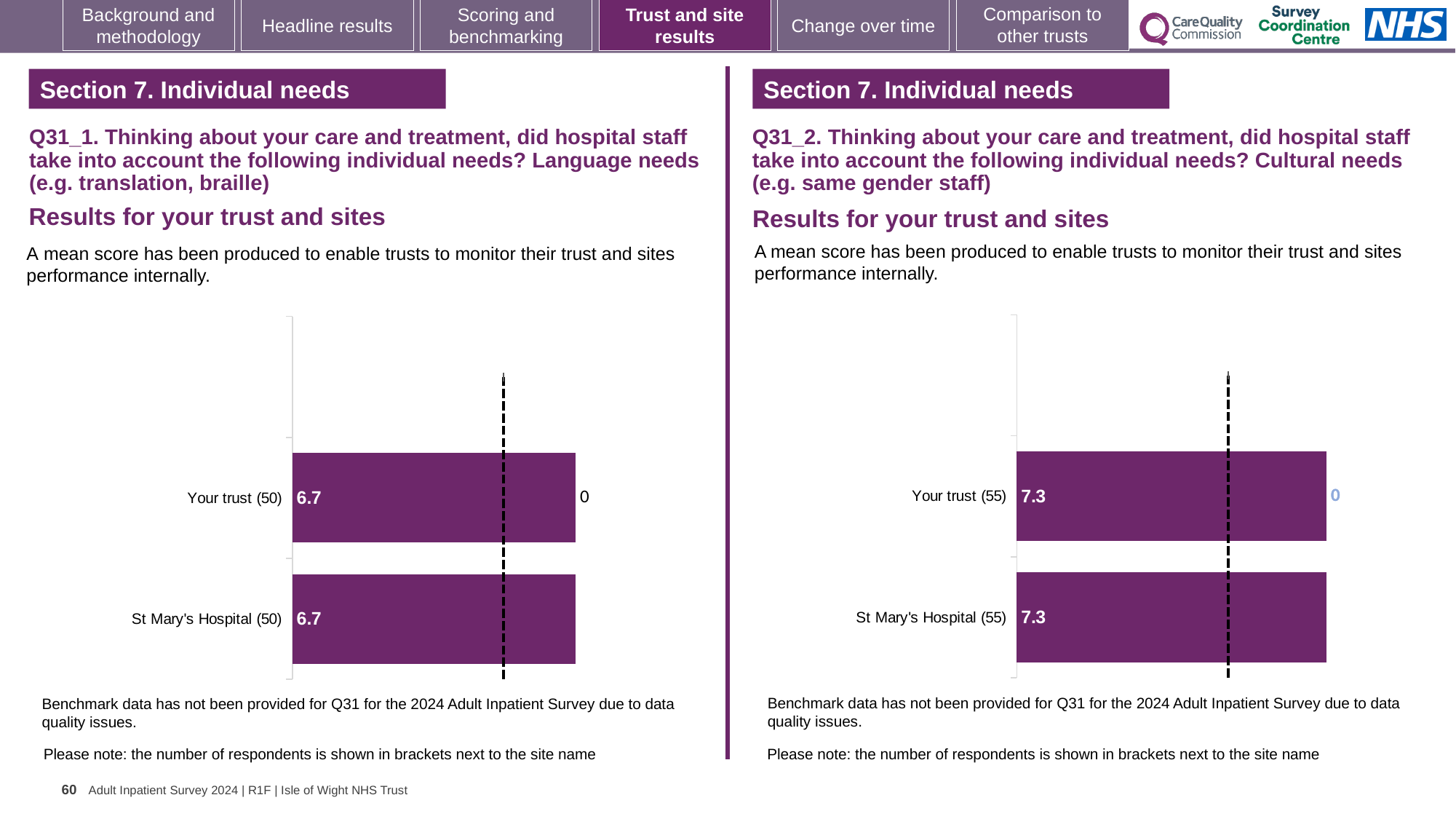
What type of chart is used in the left chart (Q31_1, Language needs)? Bar chart In the right chart (Q31_2, Cultural needs), what is the mean score for St Mary's Hospital? 7.3 How many bars are plotted in the left chart (Q31_1, Language needs)? 2 In the left chart (Q31_1, Language needs), what is the mean score for Your trust? 6.7 In the right chart (Q31_2, Cultural needs), what is the difference between the scores for Your trust and St Mary's Hospital? 0 How many bars are plotted in the right chart (Q31_2, Cultural needs)? 2 In the left chart (Q31_1, Language needs), what is the difference between the scores for Your trust and St Mary's Hospital? 0 In the right chart (Q31_2, Cultural needs), what is the mean score for Your trust? 7.3 In the left chart (Q31_1, Language needs), how many respondents are shown in brackets next to Your trust? 50 In the right chart (Q31_2, Cultural needs), how many respondents are shown in brackets next to St Mary's Hospital? 55 Which is larger: the Your trust score in the left chart (Q31_1) or the Your trust score in the right chart (Q31_2)? Q31_2 (right chart) In the left chart (Q31_1, Language needs), what is the mean score for St Mary's Hospital? 6.7